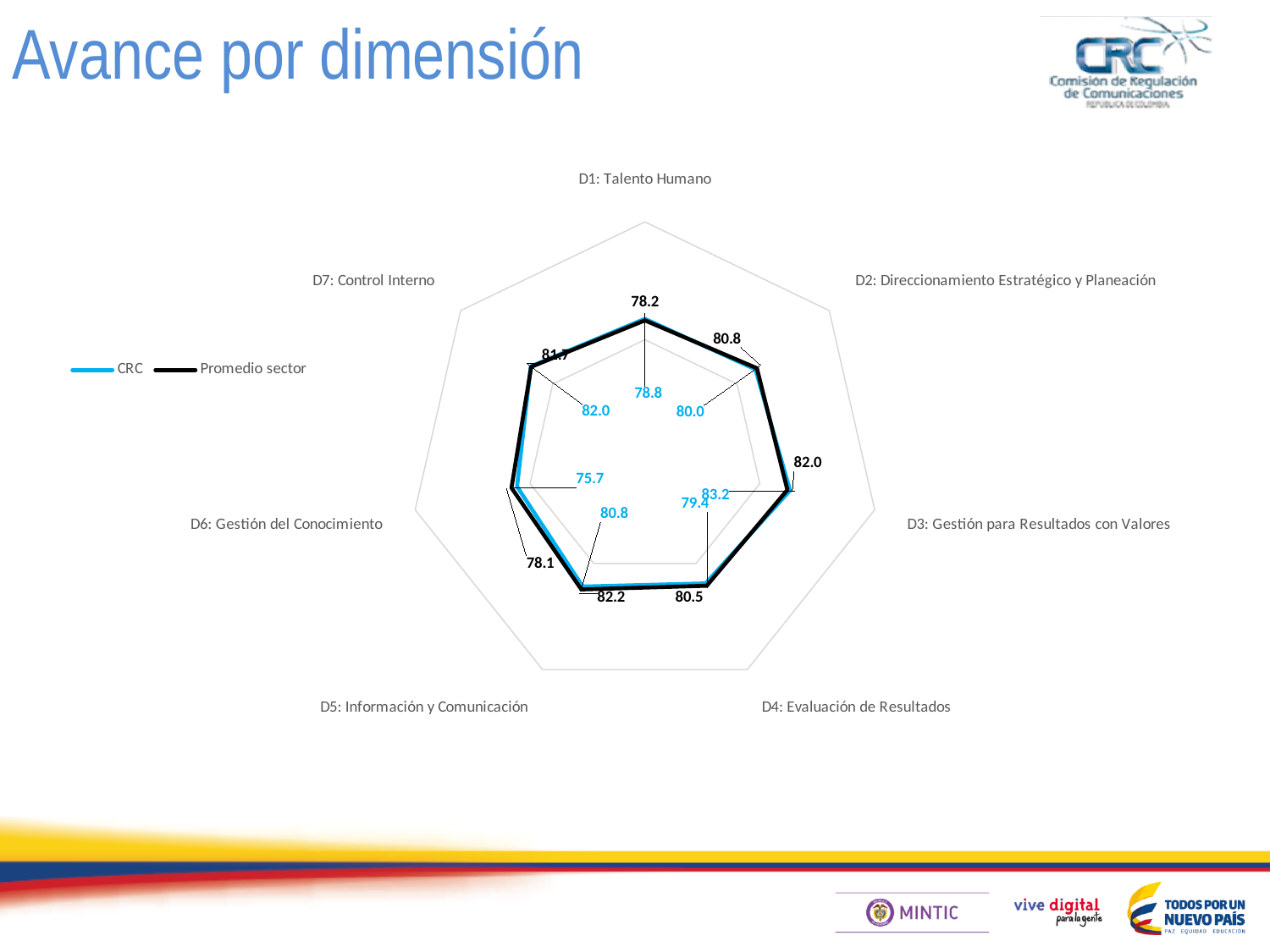
For D3: Gestión para Resultados con Valores, which series has the larger value, CRC or Promedio sector? CRC How many dimensions (categories) are plotted on the chart? 7 What type of chart is shown on the slide? Radar chart What is the title of the slide containing the chart? Avance por dimensión How many series does the legend list? 2 What is the CRC value for D6: Gestión del Conocimiento? 75.7 In which dimension does CRC have its lowest value? D6: Gestión del Conocimiento What is the CRC value for D3: Gestión para Resultados con Valores? 83.2 What is the Promedio sector value for D5: Información y Comunicación? 82.2 What is the Promedio sector value for D1: Talento Humano? 78.2 In which dimension does CRC have its highest value? D3: Gestión para Resultados con Valores What is the difference between the Promedio sector value and the CRC value for D6: Gestión del Conocimiento? 2.4